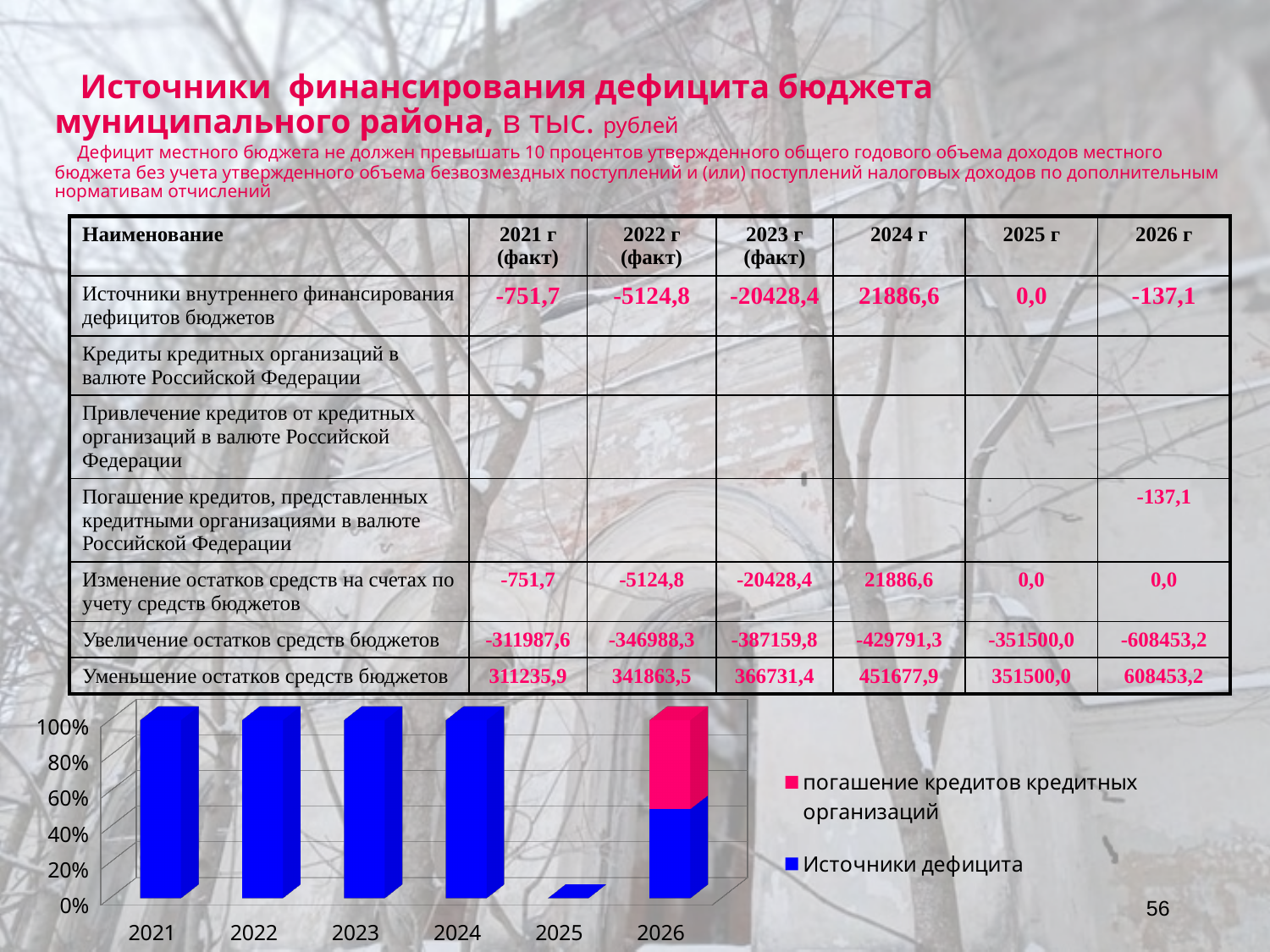
Which series in the bar chart is shown in pink? погашение кредитов кредитных организаций Which series in the bar chart is shown in blue? Источники дефицита How many series does the legend of the bar chart list? 2 In the bar chart, is the blue segment (Источники дефицита) for 2021 greater or less than 80%? greater How many years are shown on the x axis of the bar chart? 6 In the bar chart, which year is the only one with a visible pink segment (погашение кредитов кредитных организаций)? 2026 What kind of chart is shown at the bottom of the slide? bar chart In the bar chart, which year has the smallest total bar? 2025 In the bar chart, is the blue segment (Источники дефицита) for 2026 greater or less than 80%? less In the bar chart, is the bar for 2025 greater or less than 20%? less In the bar chart, is the blue segment for 2024 larger or smaller than the blue segment for 2026? larger